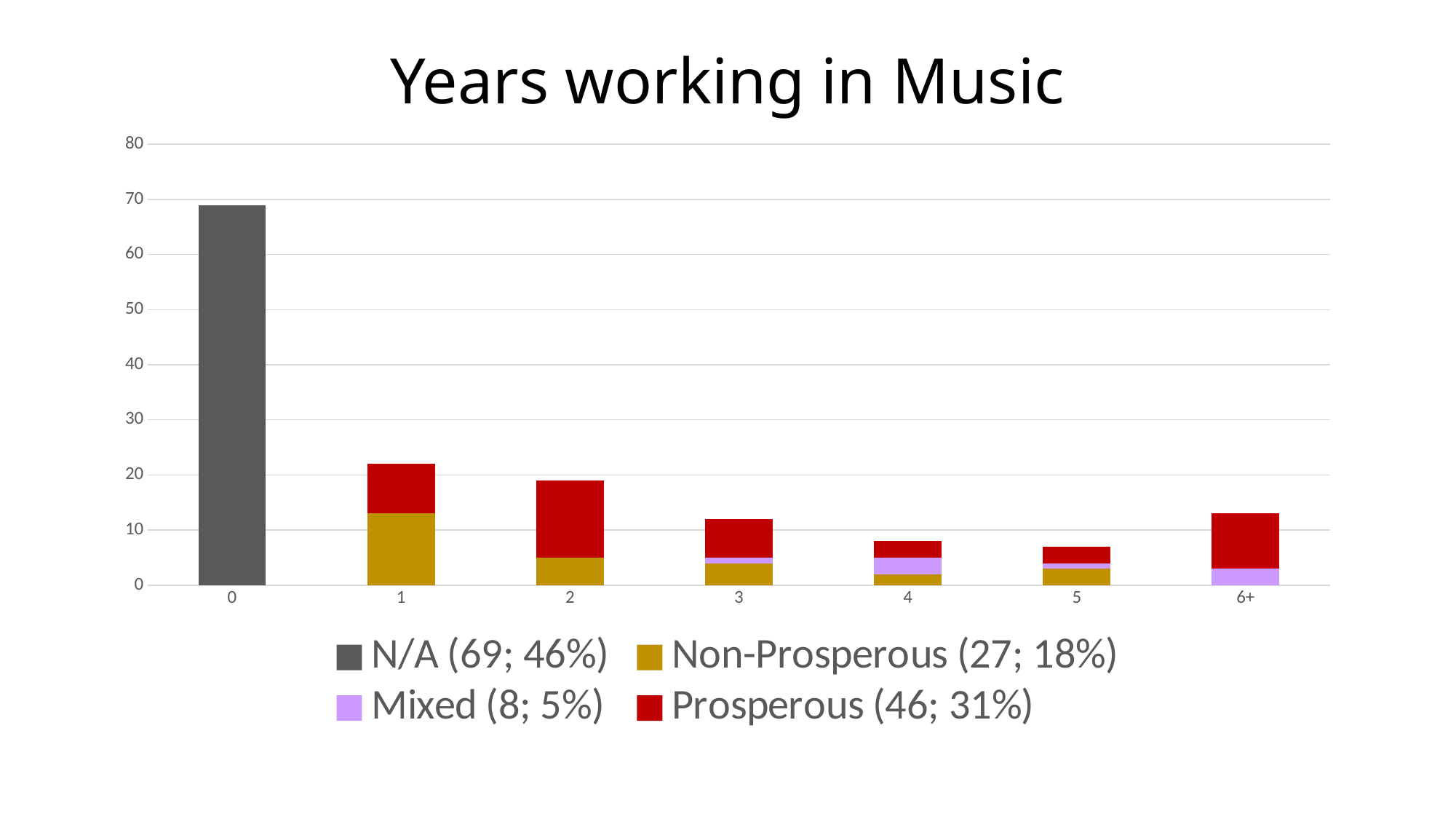
Which bar is taller, category 2 or category 3? 2 Which category has the tallest bar? 0 What kind of chart is shown on the slide? stacked bar chart Is the total bar for category 6+ greater or less than 10? greater According to the legend, what percentage of respondents are Prosperous? 31% Is the total bar for category 5 greater or less than 10? less Is the total bar for category 0 greater or less than 60? greater What is the title of the chart? Years working in Music Which bar is taller, category 1 or category 6+? 1 According to the legend, how many respondents are in the N/A group? 69 How many series does the legend list? 4 How many categories are shown on the x axis? 7